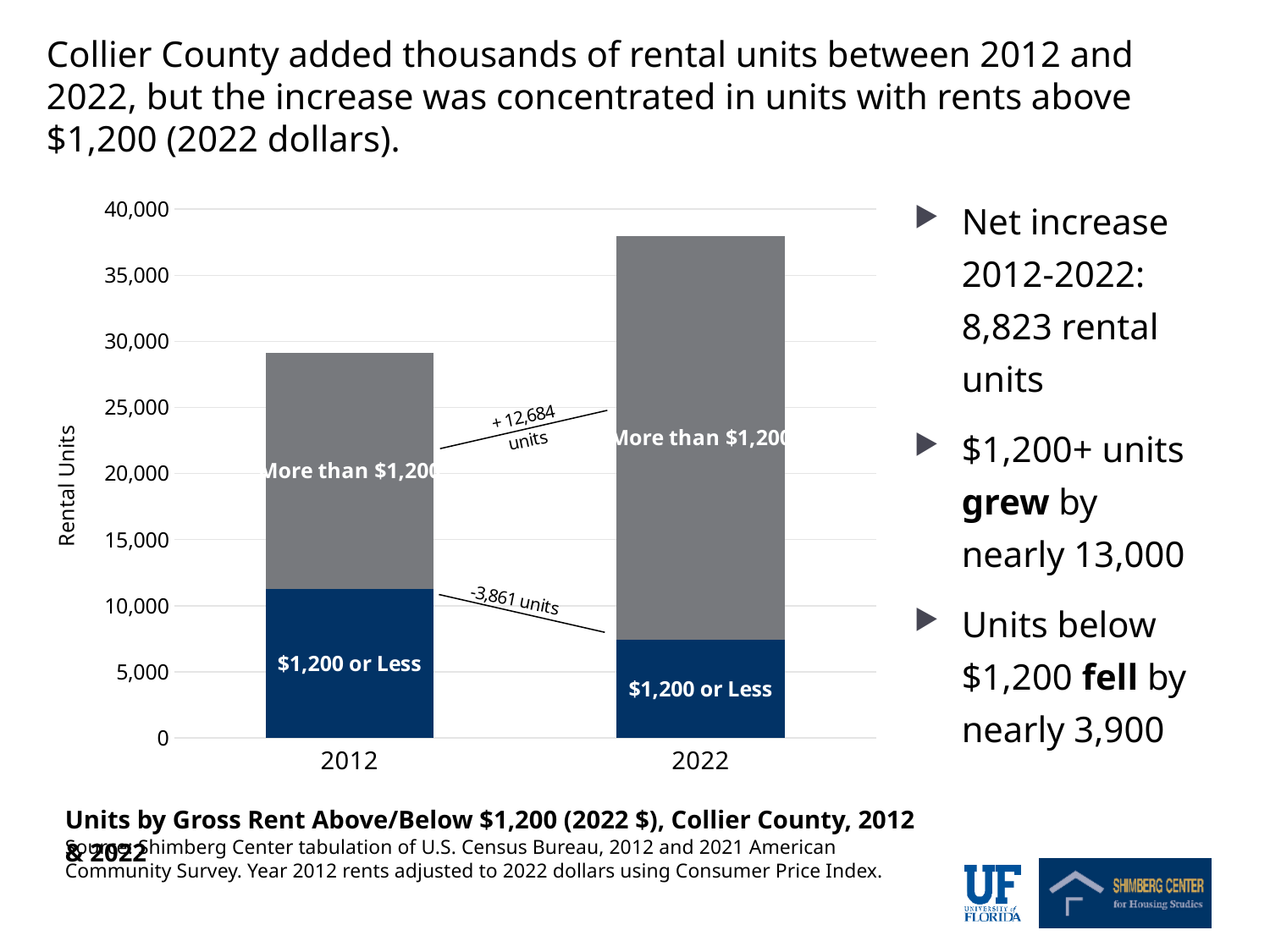
How many rent segments make up each stacked bar in the chart? 2 According to the annotation on the chart, by how many units did the 'More than $1,200' segment change between 2012 and 2022? +12,684 units Is the '$1,200 or Less' value for 2022 greater or less than 10,000? less What kind of chart is shown on the slide? Stacked bar chart According to the annotation on the chart, by how many units did the '$1,200 or Less' segment change between 2012 and 2022? -3,861 units What is the label on the vertical axis of the chart? Rental Units Is the '$1,200 or Less' segment larger in 2012 or in 2022? 2012 Is the total number of rental units in 2022 greater or less than 35,000? greater Does the total number of rental units rise or fall from 2012 to 2022? rise How many years (categories) are shown on the x axis of the chart? 2 Which year has the taller total bar in the chart, 2012 or 2022? 2022 Is the total number of rental units in 2012 greater or less than 30,000? less